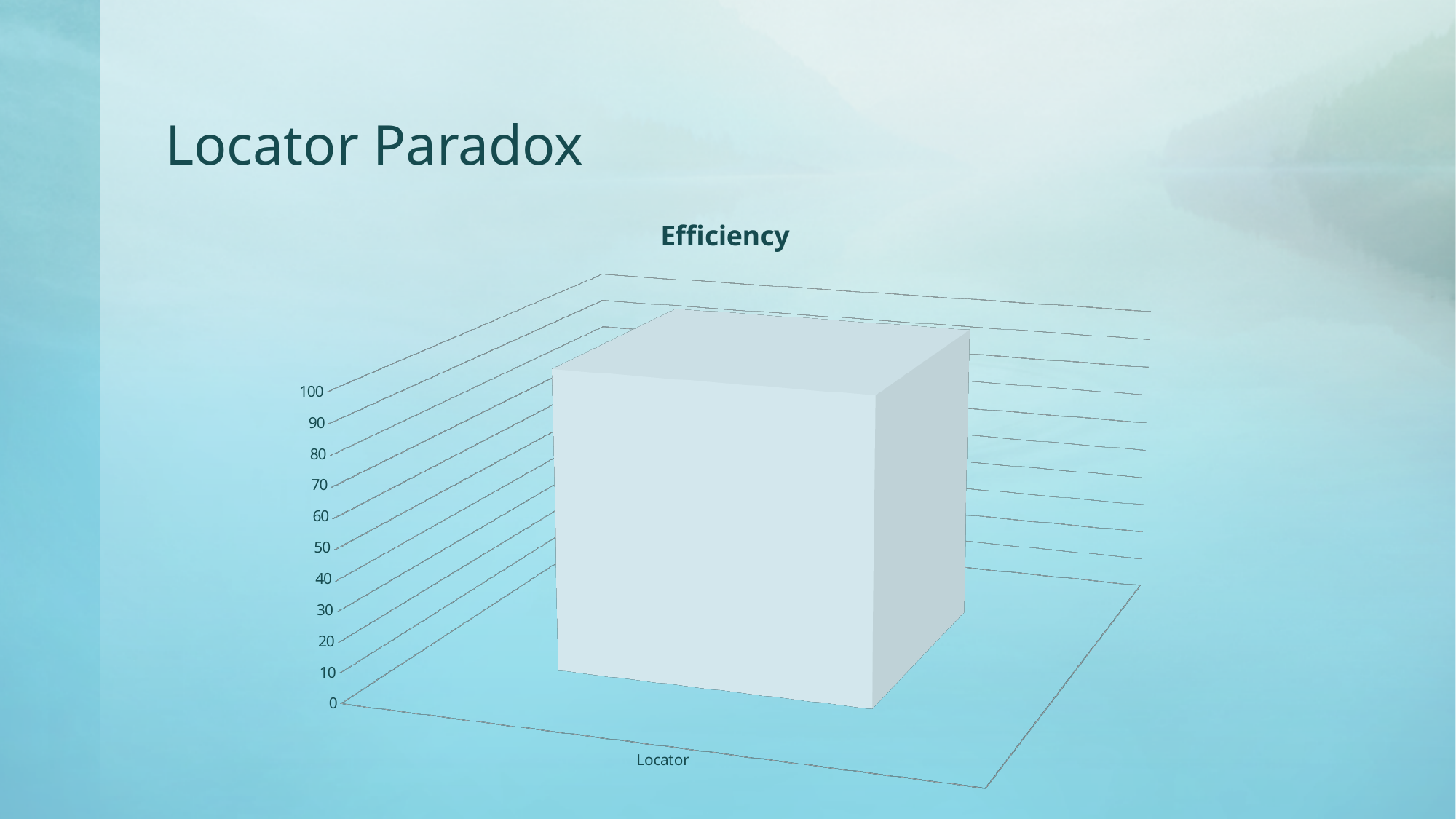
How many categories are plotted in the Efficiency chart? 1 What is the label of the single category on the x axis of the Efficiency chart? Locator What is the title of the chart? Efficiency Is the value for Locator greater or less than 50? greater Is the value for Locator greater or less than 70? greater Is the value for Locator greater or less than 30? greater What is the highest tick value shown on the vertical axis of the Efficiency chart? 100 What kind of chart is shown on the slide? bar chart